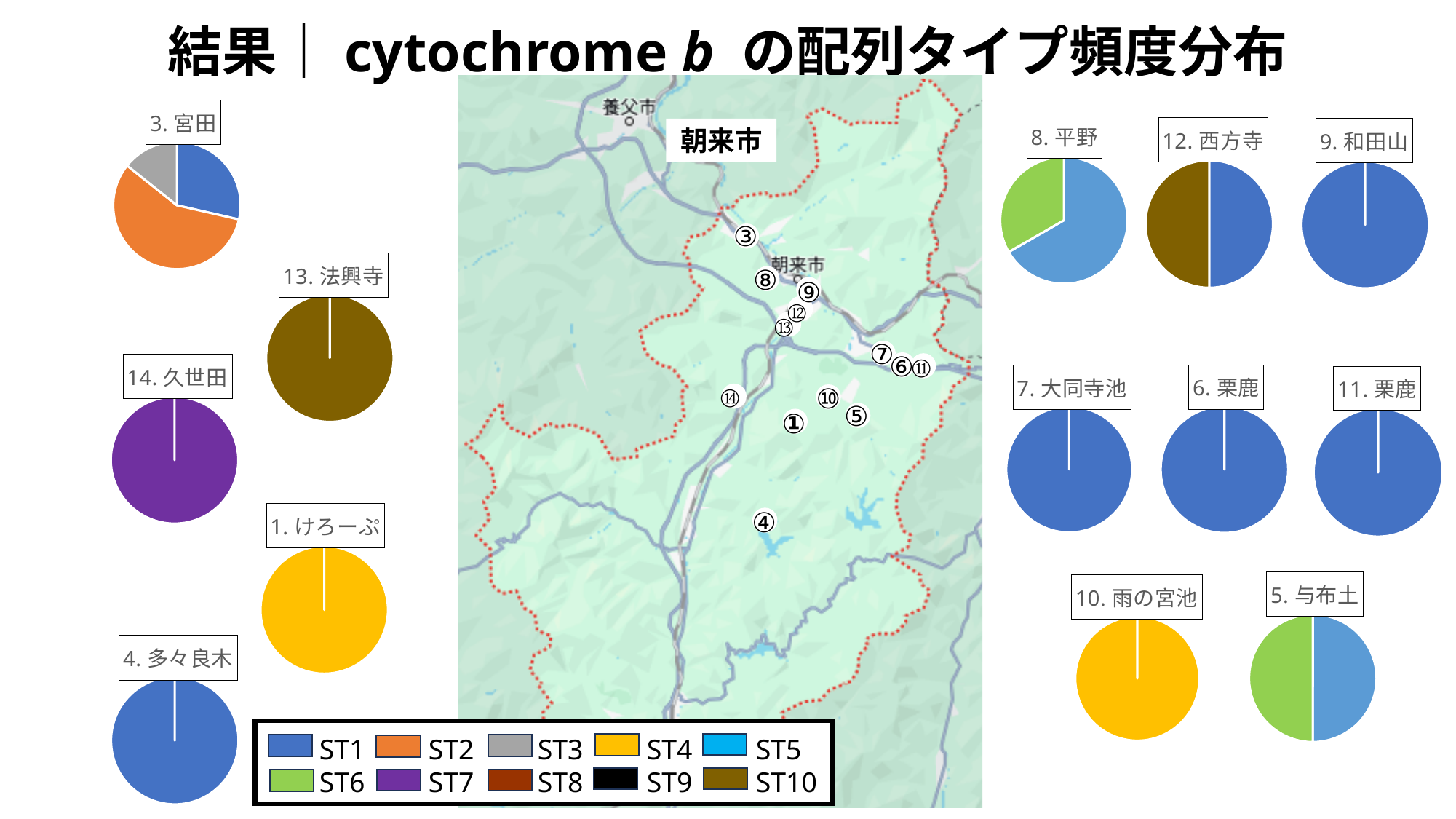
Which sequence type makes up the entire pie chart for 13. 法興寺? ST10 How many sequence types does the legend list? 10 In the pie chart for 3. 宮田, which sequence type has the smallest share? ST3 Which sequence type makes up the entire pie chart for 1. けろーぷ? ST4 Which two sequence types appear in the pie chart for 12. 西方寺? ST1 and ST10 In the pie chart for 8. 平野, how many slices are there? 2 In the pie chart for 3. 宮田, which sequence type has the largest share? ST2 How many pie charts are shown on the slide? 13 What kind of charts are used on this slide to show the sequence type frequencies? pie charts In the pie chart for 8. 平野, which sequence type has the larger share, ST5 or ST6? ST5 Which sequence type makes up the entire pie chart for 14. 久世田? ST7 In the pie chart for 3. 宮田, how many slices are there? 3